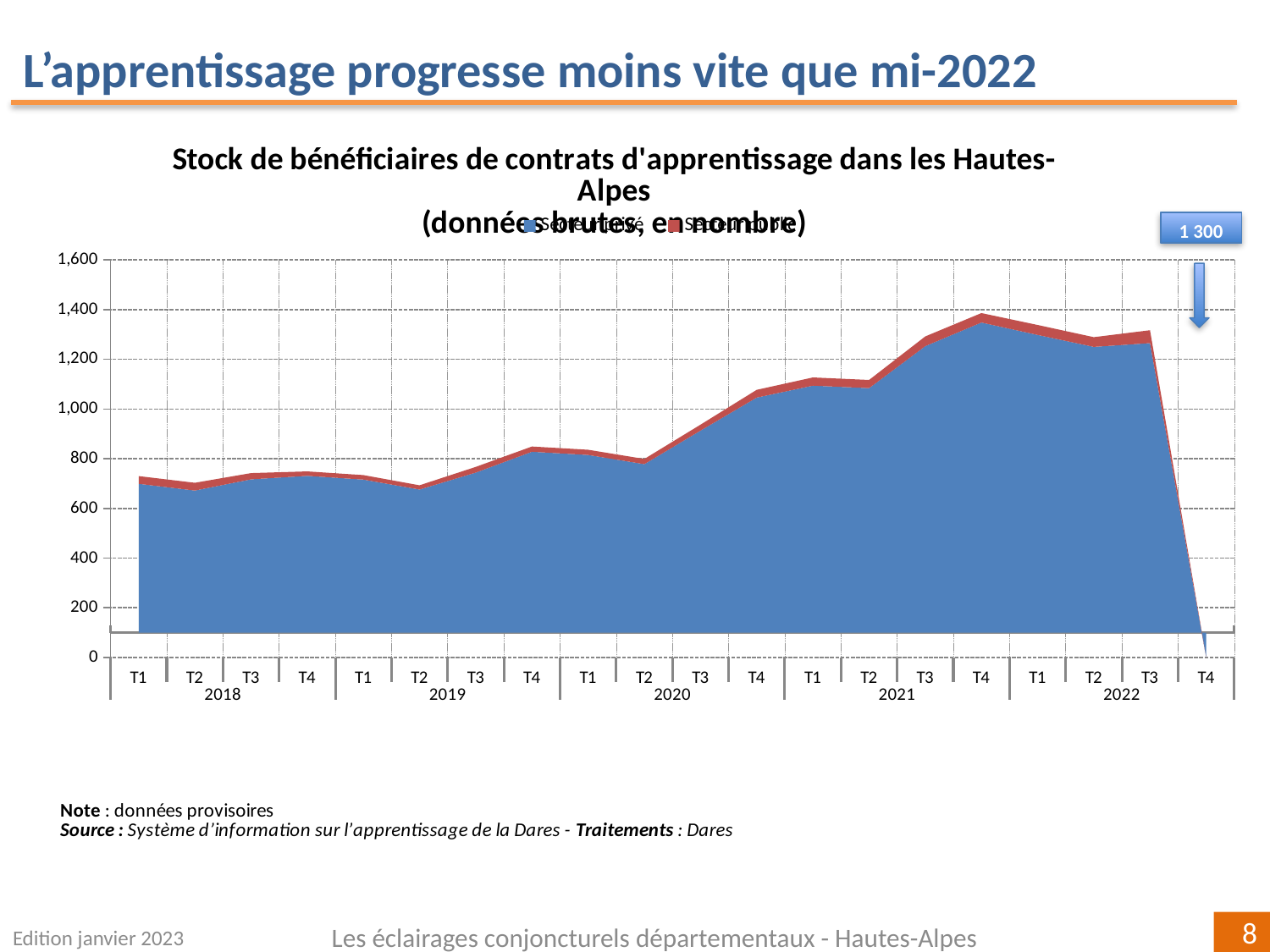
How many quarterly points are shown along the x axis? 20 Overall, do the values rise or fall from T1 2018 to T4 2021? rise How many years are shown along the x axis? 5 Is the total value for T1 2020 greater or less than 1,000? less Which quarter has the highest total value on the chart? T4 2021 Is the total value for T4 2021 greater or less than 1,200? greater Is the total value for T1 2018 greater or less than 600? greater How many series does the legend list? 2 What kind of chart is shown on the slide? Area chart What is the title of the chart? Stock de bénéficiaires de contrats d'apprentissage dans les Hautes-Alpes (données brutes, en nombre)